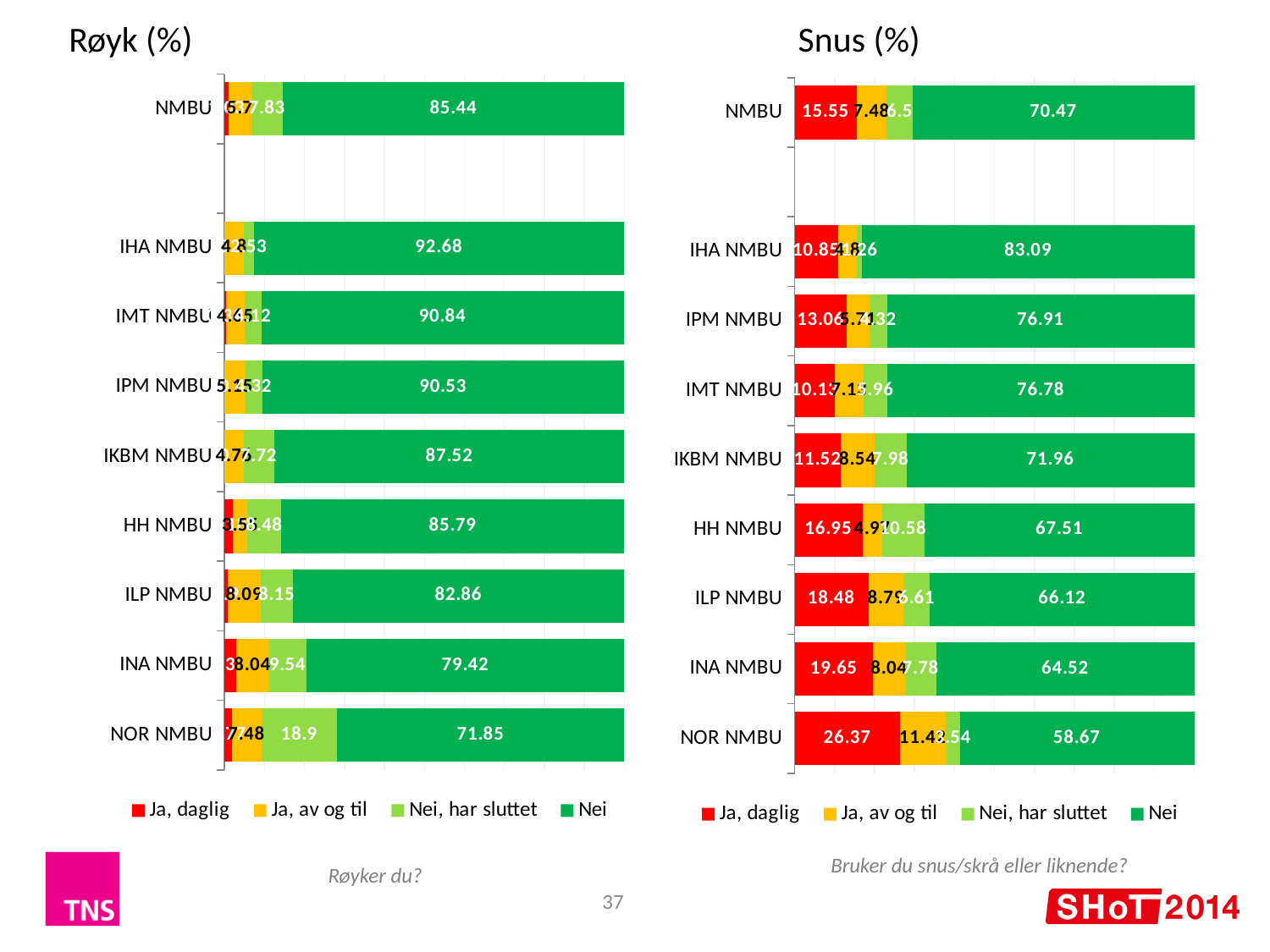
In the Røyk (%) chart, what is the 'Nei' value for IHA NMBU? 92.68 How many categories are shown in the Røyk (%) chart? 9 In the Røyk (%) chart, which category has the highest 'Nei' value? IHA NMBU In the Røyk (%) chart, which category has the lowest 'Nei' value? NOR NMBU In the Røyk (%) chart, what is the 'Nei, har sluttet' value for NOR NMBU? 18.9 In the Røyk (%) chart, which has the larger 'Nei' value, ILP NMBU or INA NMBU? ILP NMBU In the Snus (%) chart, what is the 'Ja, daglig' value for NOR NMBU? 26.37 In the Snus (%) chart, what is the 'Nei' value for HH NMBU? 67.51 How many series does the legend of the Snus (%) chart list? 4 What kind of chart is the Snus (%) chart? Stacked bar chart In the Snus (%) chart, what is the difference between the 'Nei' values for IHA NMBU and NOR NMBU? 24.42 In the Snus (%) chart, which category has the highest 'Ja, daglig' value? NOR NMBU